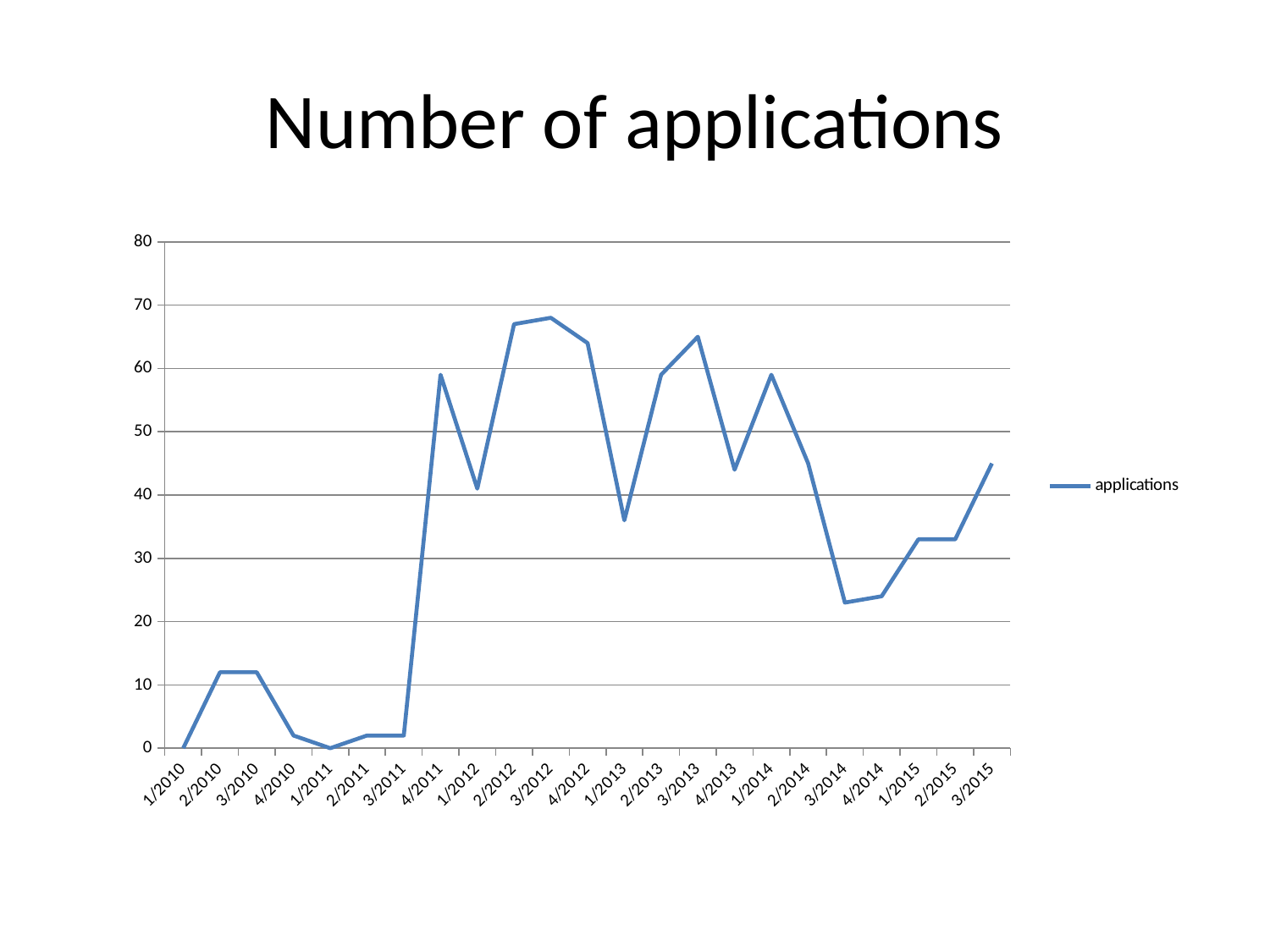
What is the value for 1/2010? 0 Is the value for 4/2013 greater or less than 50? less Is the value for 3/2014 greater or less than 30? less How many quarterly points are plotted along the x axis? 23 What kind of chart is shown on the slide? line chart Is the value for 3/2013 greater or less than 60? greater Which is larger, the value for 2/2014 or the value for 3/2014? 2/2014 Which is larger, the value for 3/2013 or the value for 4/2013? 3/2013 Do the values rise or fall from 3/2014 to 3/2015? rise How many series does the legend list? 1 What is the title of the chart? Number of applications